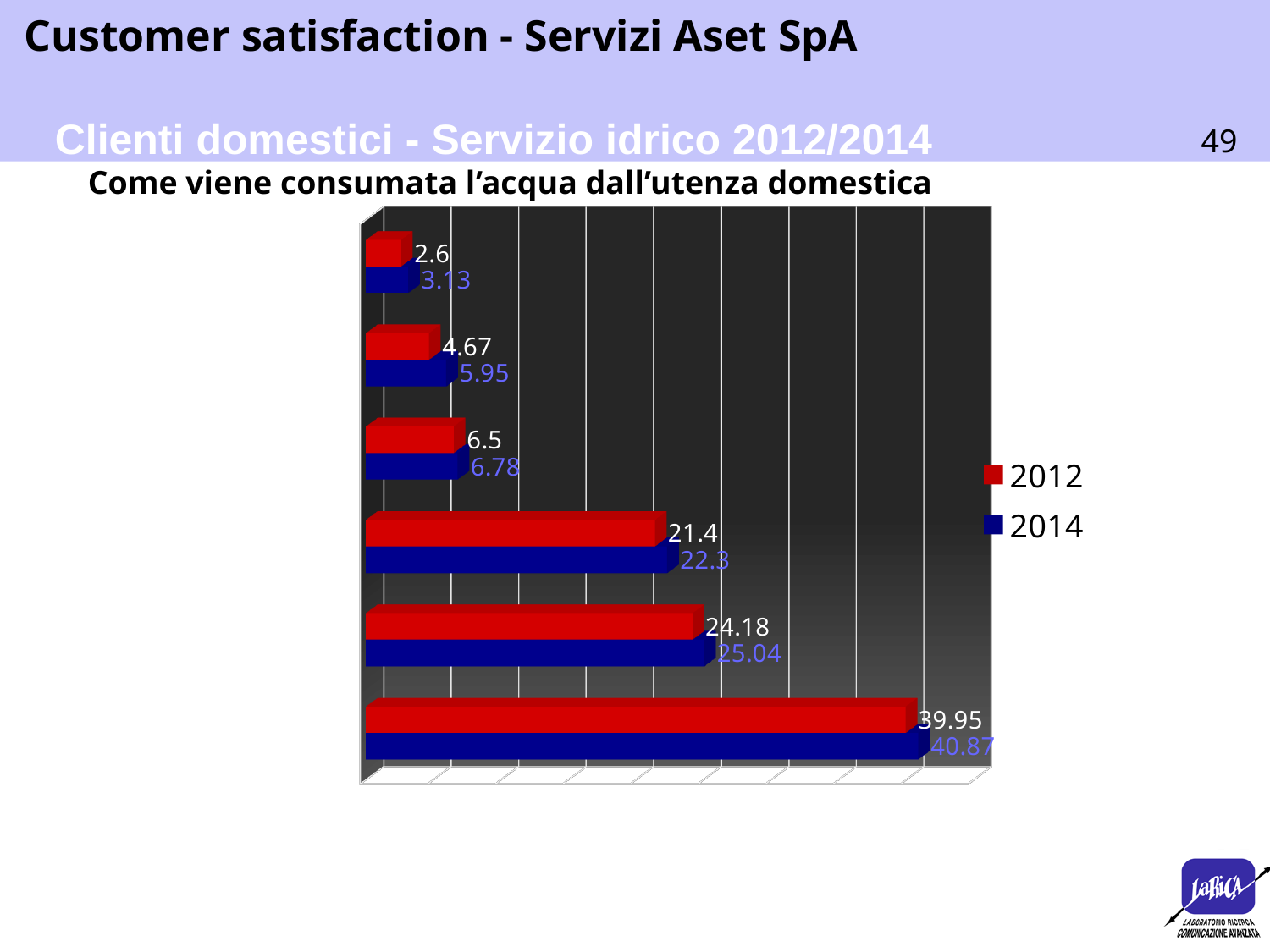
How many pairs of bars (categories) are plotted in the chart? 6 What kind of chart is shown on the slide? bar chart What is the lowest 2012 value shown in the chart? 2.6 What is the highest 2014 value shown in the chart? 40.87 How many series does the legend list? 2 What is the 2014 value for the topmost category in the chart? 3.13 What is the 2012 value for the bottom category in the chart? 39.95 What is the 2012 value for the second category from the top? 4.67 What is the difference between the 2014 and 2012 values for the bottom category? 0.92 What is the 2014 value for the bottom category in the chart? 40.87 Which years are listed in the legend? 2012 and 2014 For the third category from the top, which is larger: the 2012 value or the 2014 value? 2014